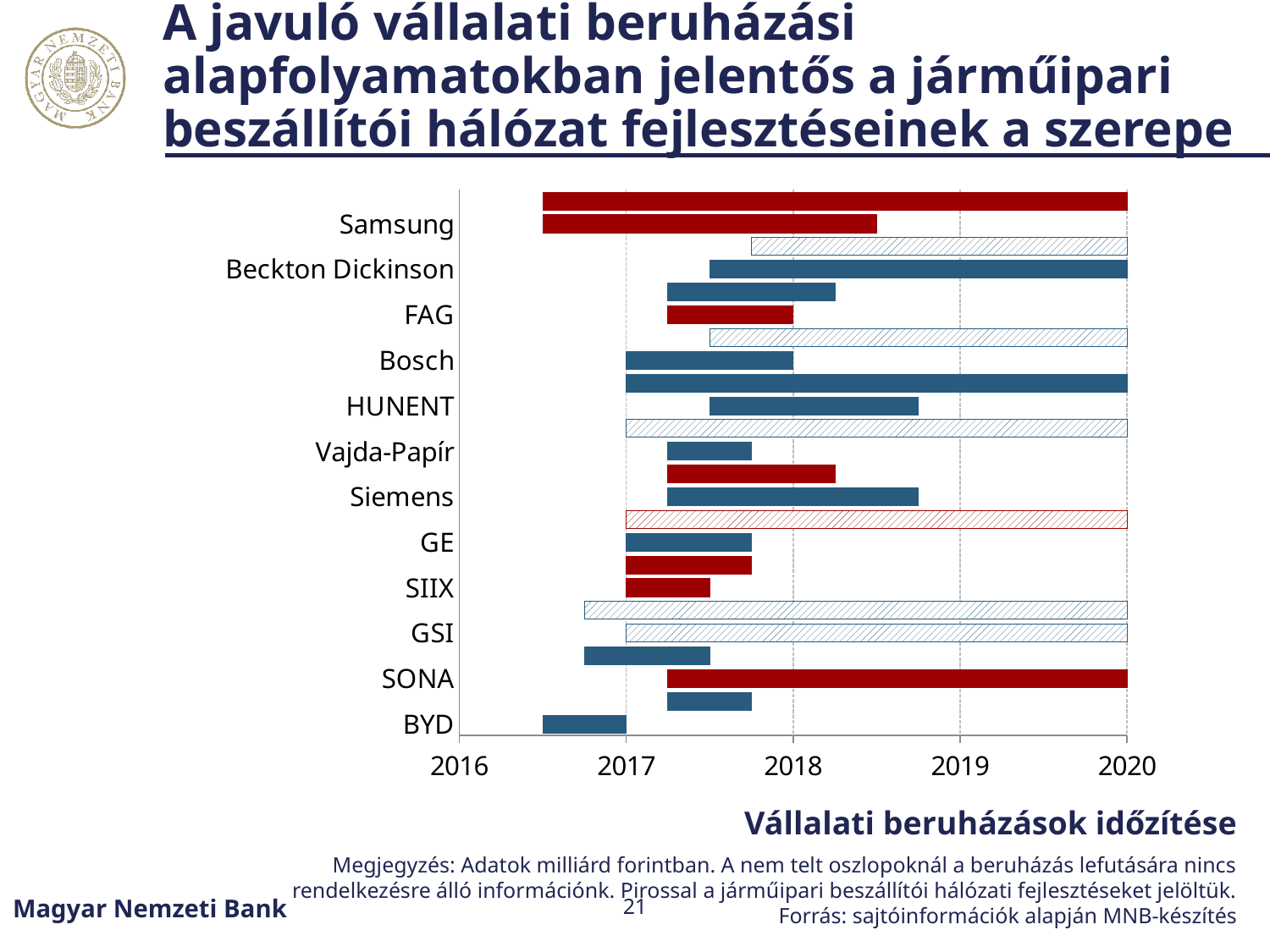
According to the note, what do the red bars represent? járműipari beszállítói hálózati fejlesztések What is the first year shown on the horizontal axis? 2016 In which year does the bar aligned with the Bosch label start? 2017 Does the bar aligned with the Samsung label start before or after 2017? before In which year does the bar aligned with the BYD label end? 2017 How many company labels are listed on the vertical axis of the chart? 12 Which company label is at the bottom of the vertical axis? BYD What kind of chart is shown on the slide? bar chart Does the bar aligned with the BYD label end before or after 2018? before Which company label is at the top of the vertical axis? Samsung What is the last year shown on the horizontal axis? 2020 What is the title printed below the chart? Vállalati beruházások időzítése